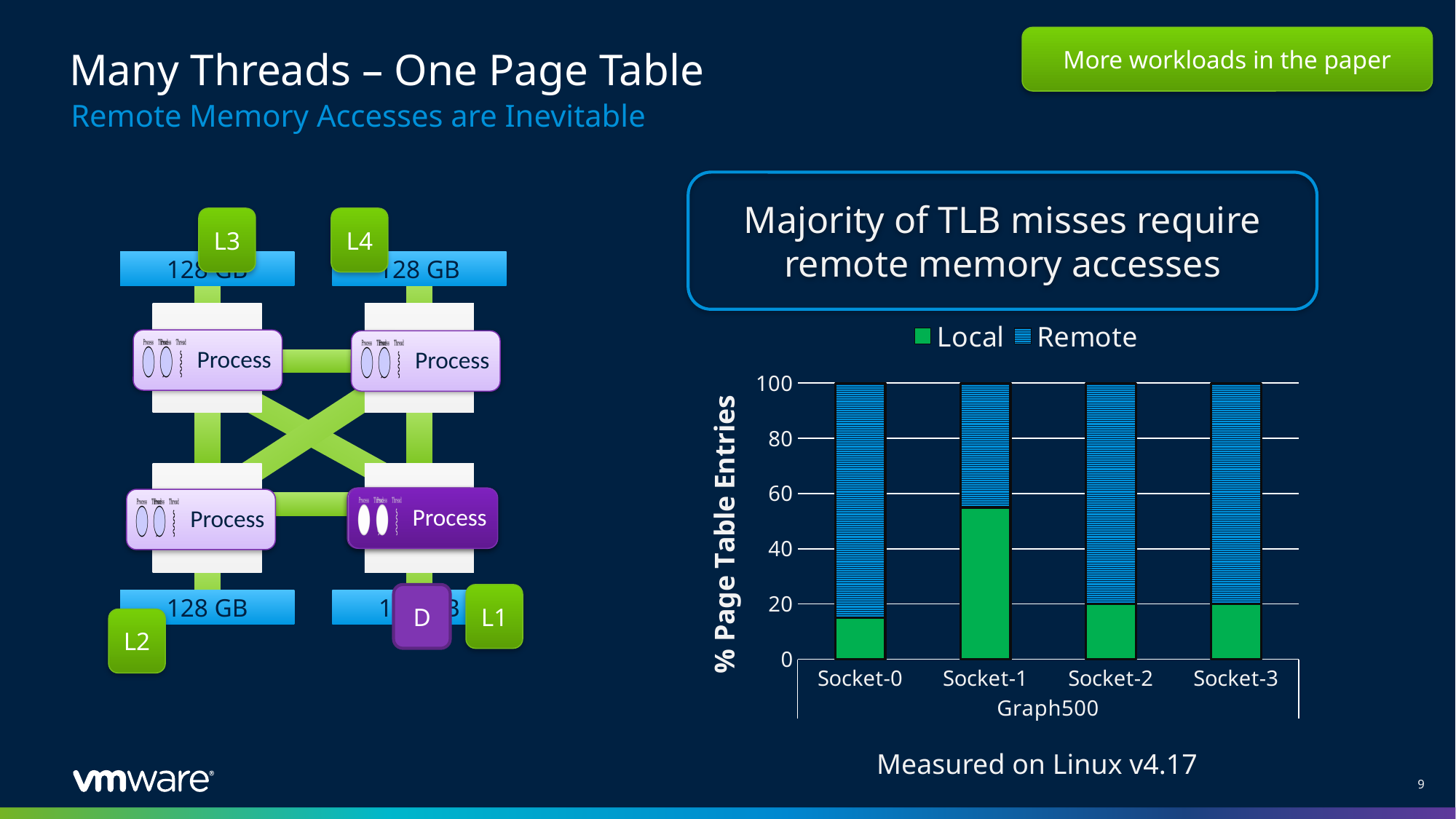
How many sockets (categories) are plotted on the x axis of the chart? 4 How many series does the chart's legend list? 2 Which is larger, the Local value for Socket-0 or the Local value for Socket-1? Socket-1 What is the label on the chart's y axis? % Page Table Entries What kind of chart is shown on the slide? stacked bar chart Which socket has the smallest Local share of page table entries? Socket-0 Is the Local value for Socket-1 greater or less than 40? greater Is the Remote value for Socket-2 greater or less than 60? greater What workload name is shown beneath the socket labels on the x axis? Graph500 Which socket has the largest Remote share of page table entries? Socket-0 Which socket has the largest Local share of page table entries? Socket-1 Is the Local value for Socket-0 greater or less than 20? less